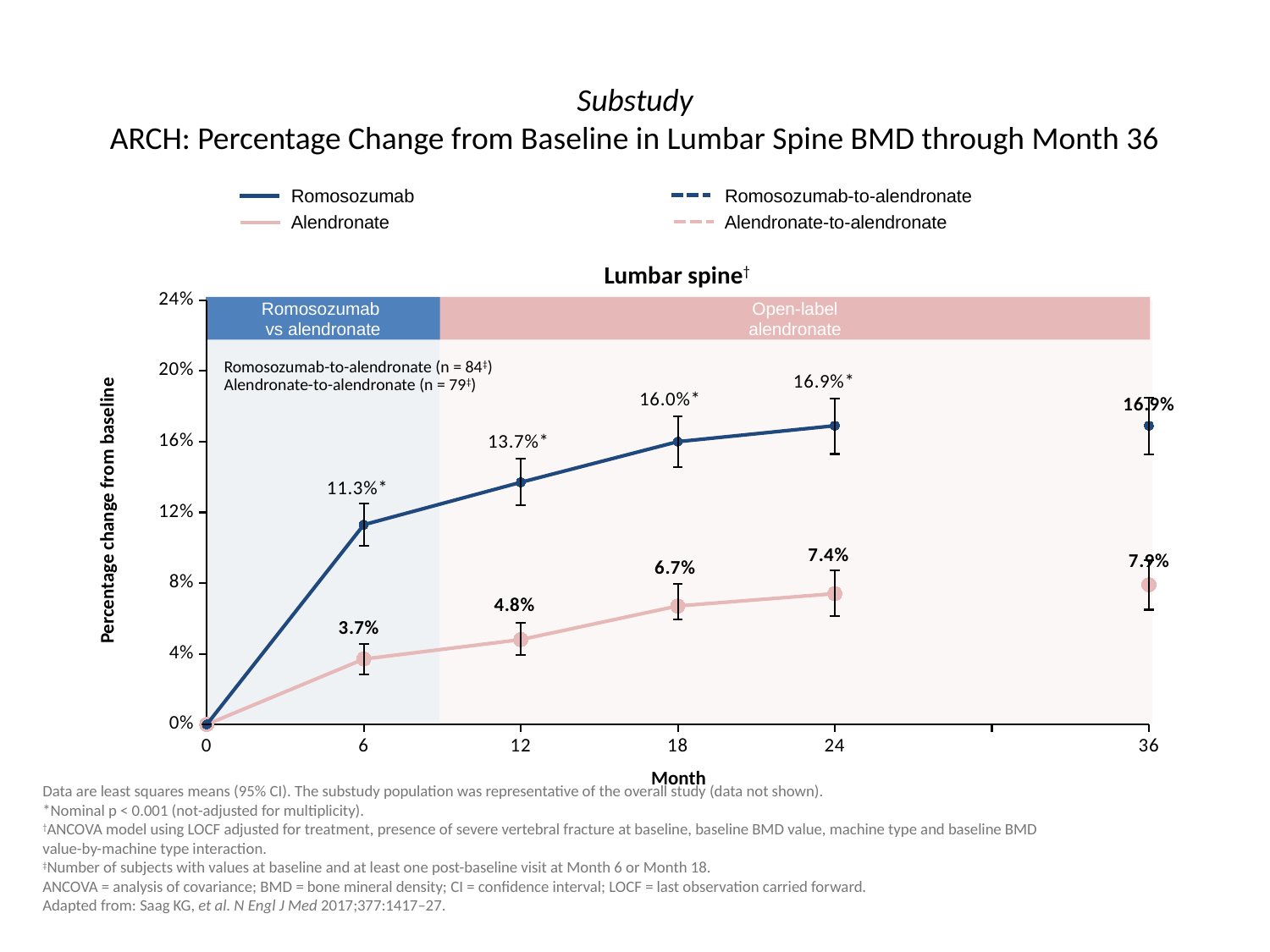
What kind of chart is shown on the slide? Line chart Is the value for the romosozumab-to-alendronate group at month 36 greater or less than 12%? greater What is the percentage change from baseline for the alendronate group at month 12? 4.8% How many series does the legend list? 4 What is the percentage change from baseline for the alendronate-to-alendronate group at month 18? 6.7% Does the percentage change from baseline for the alendronate group rise or fall from month 0 to month 24? Rise What is the difference between the romosozumab and alendronate groups in percentage change from baseline at month 6? 7.6% What is the difference between the romosozumab and alendronate groups in percentage change from baseline at month 24? 9.5% What is the percentage change from baseline in lumbar spine BMD for the romosozumab group at month 6? 11.3% Which group has the higher percentage change from baseline at month 18, romosozumab or alendronate? Romosozumab Is the value for the alendronate-to-alendronate group at month 36 greater or less than 12%? less What is the percentage change from baseline for the romosozumab-to-alendronate group at month 24? 16.9%